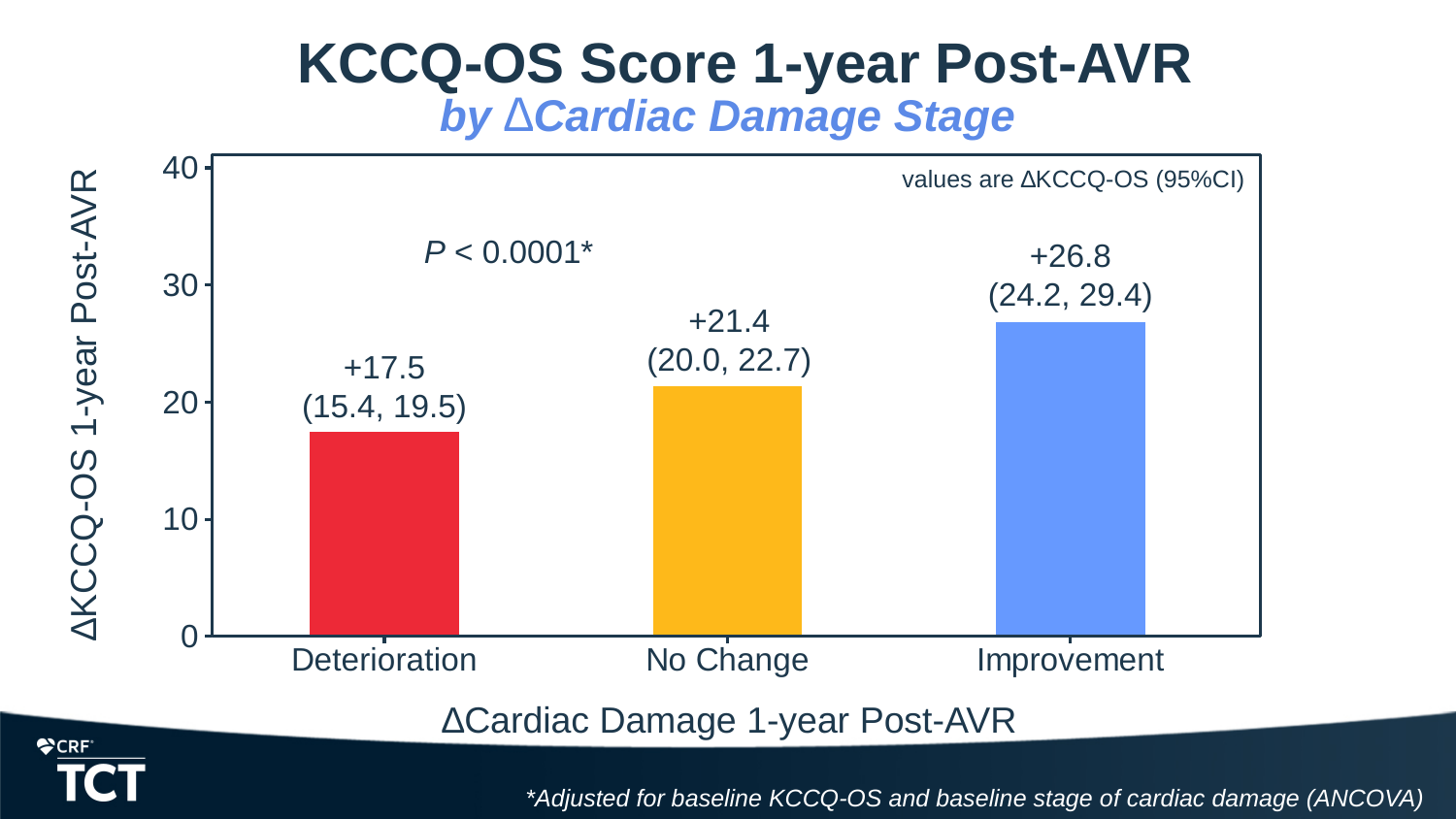
What is the ΔKCCQ-OS value for the Deterioration group? +17.5 Which group has a larger ΔKCCQ-OS value, No Change or Deterioration? No Change What P value is printed on the chart? P < 0.0001* What is the difference between the ΔKCCQ-OS values for Improvement and Deterioration? 9.3 What kind of chart is shown on the slide? Bar chart Which ΔCardiac Damage group has the highest ΔKCCQ-OS value? Improvement What is the 95% confidence interval shown for the Improvement group? (24.2, 29.4) Is the value for the No Change group greater or less than 20? greater What is the ΔKCCQ-OS value for the No Change group? +21.4 How many ΔCardiac Damage groups are shown on the x axis? 3 What is the ΔKCCQ-OS value for the Improvement group? +26.8 Which ΔCardiac Damage group has the lowest ΔKCCQ-OS value? Deterioration